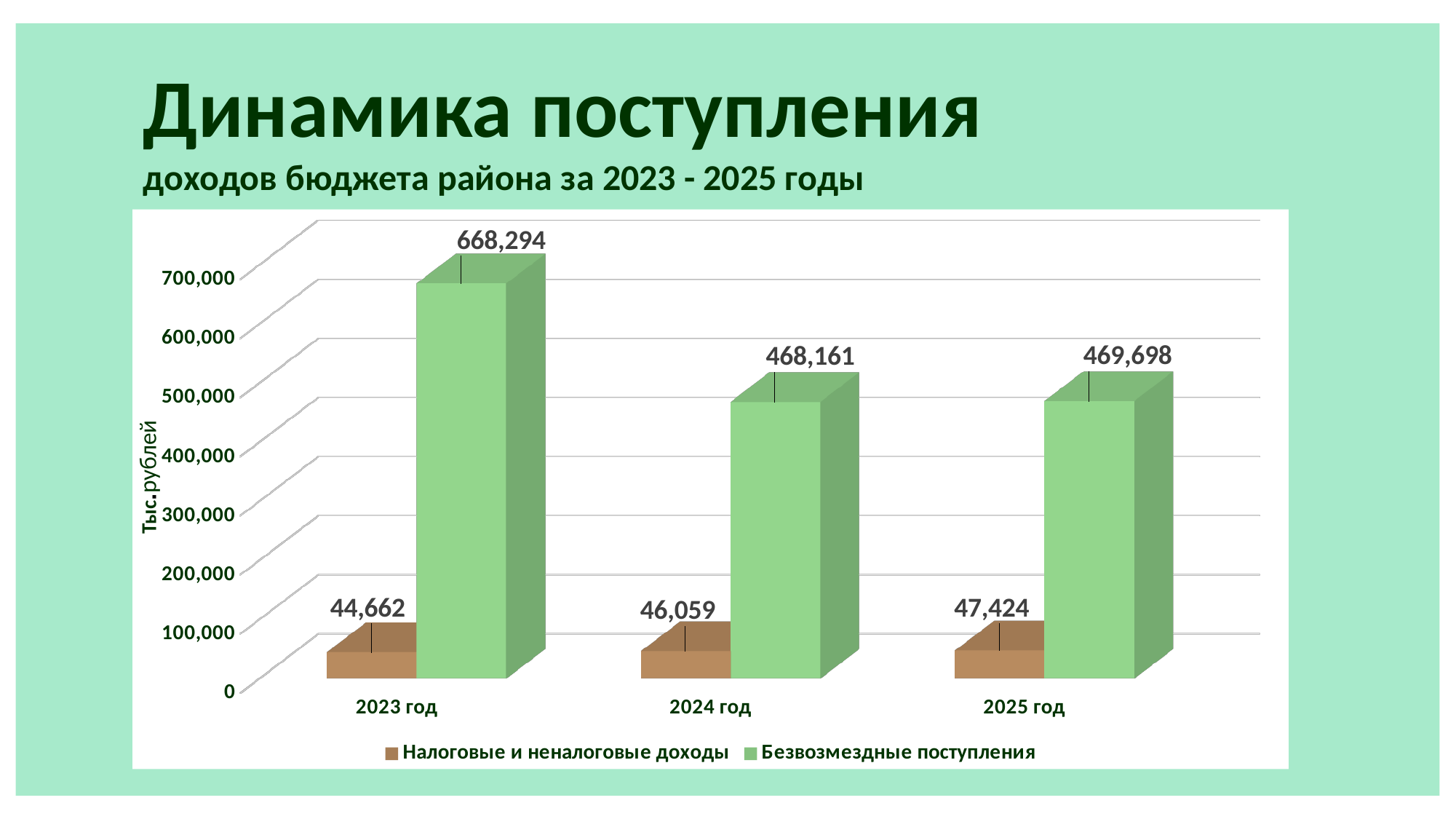
What is the value for Безвозмездные поступления in 2023 год? 668,294 Which is larger: Безвозмездные поступления in 2024 год or in 2025 год? 2025 год What is the difference between Налоговые и неналоговые доходы in 2025 год and in 2023 год? 2,762 Is the value for Безвозмездные поступления in 2024 год greater or less than 500,000? less How many series does the legend list? 2 Do the values for Налоговые и неналоговые доходы rise or fall from 2023 год to 2025 год? rise How many years are shown on the x axis? 3 In which year is the value for Безвозмездные поступления highest? 2023 год What is the value for Налоговые и неналоговые доходы in 2024 год? 46,059 In which year is the value for Налоговые и неналоговые доходы lowest? 2023 год What is the value for Налоговые и неналоговые доходы in 2025 год? 47,424 What is the difference between Безвозмездные поступления in 2023 год and in 2024 год? 200,133